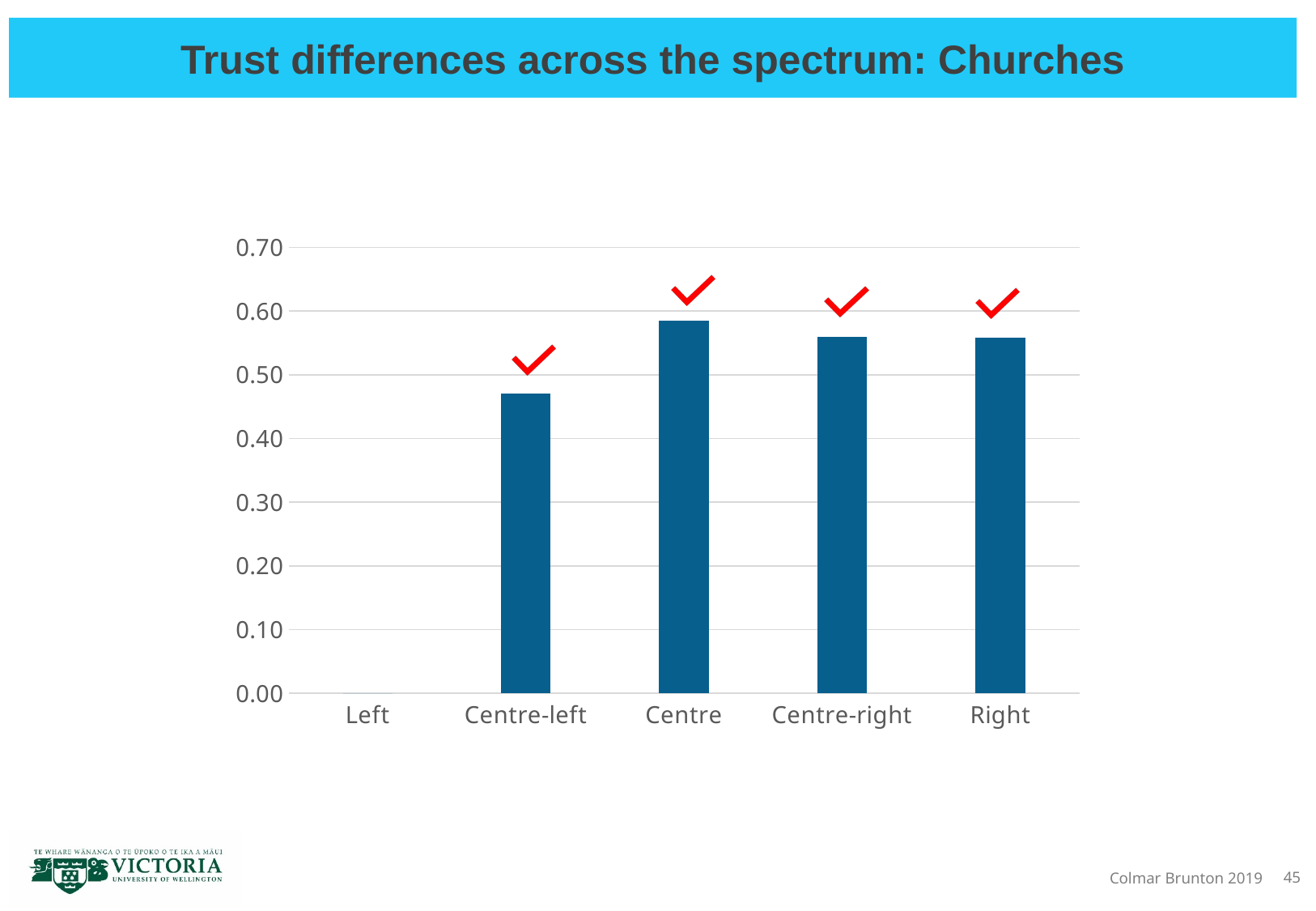
Is the value for Centre greater or less than 0.60? less Which category has the lowest value in the chart? Left How many bars in the chart have a red check mark above them? 4 Is the value for Right greater or less than 0.60? less Which category has the highest value in the chart? Centre What is the title of the slide containing the chart? Trust differences across the spectrum: Churches Which is larger, the value for Centre-left or the value for Centre? Centre What kind of chart is shown on the slide? bar chart Is the value for Centre-left greater or less than 0.50? less How many categories are shown on the x axis of the chart? 5